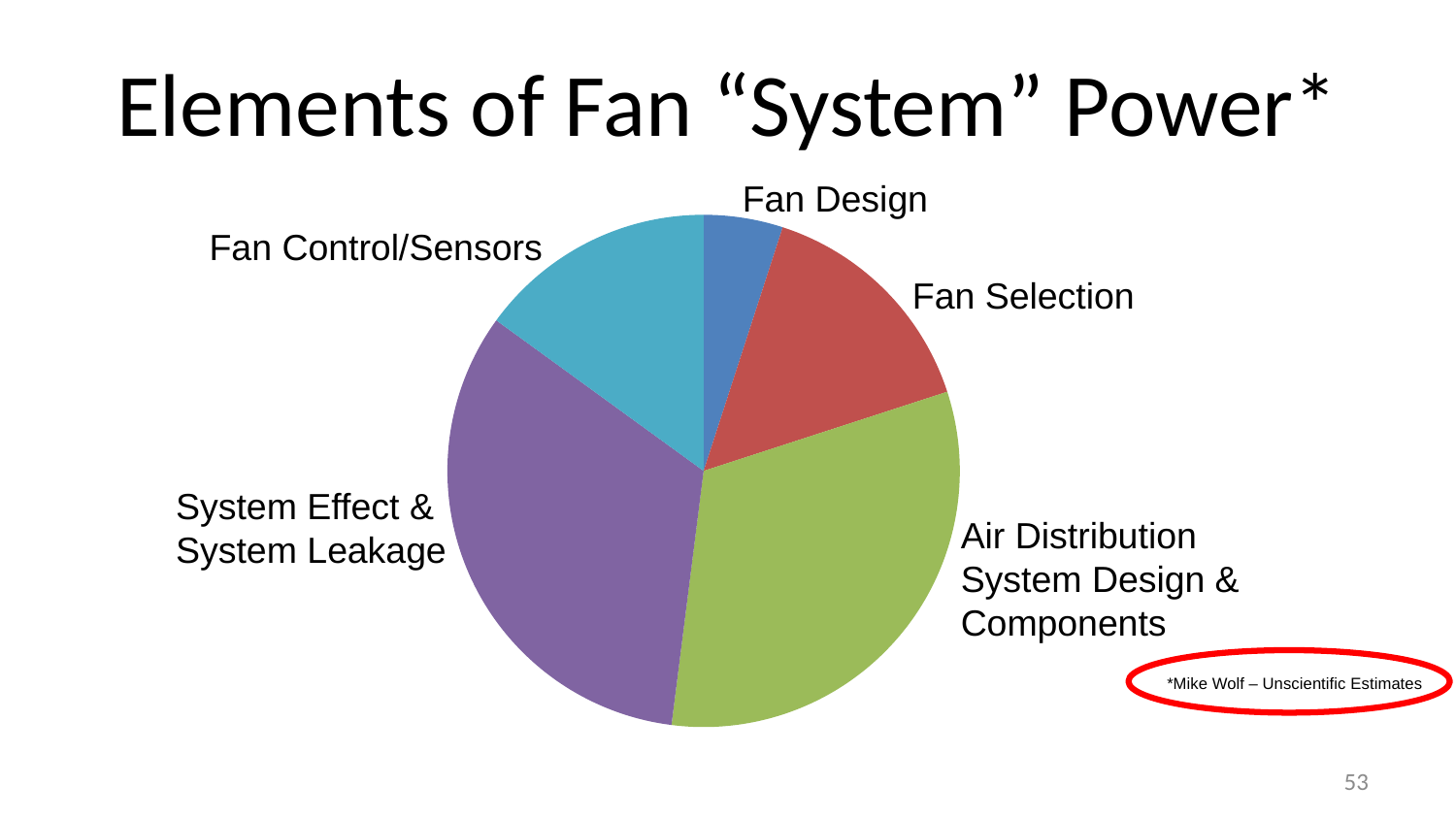
What colour is the Fan Design slice of the pie chart? Blue How many slices does the pie chart have? 5 What kind of chart is shown on the slide? Pie chart Which slice of the pie chart is the smallest? Fan Design Which slice is larger, Fan Selection or Fan Design? Fan Selection Which slice is larger, Fan Control/Sensors or Fan Design? Fan Control/Sensors Which slice is larger, System Effect & System Leakage or Fan Control/Sensors? System Effect & System Leakage What is the title of the slide containing the pie chart? Elements of Fan "System" Power*